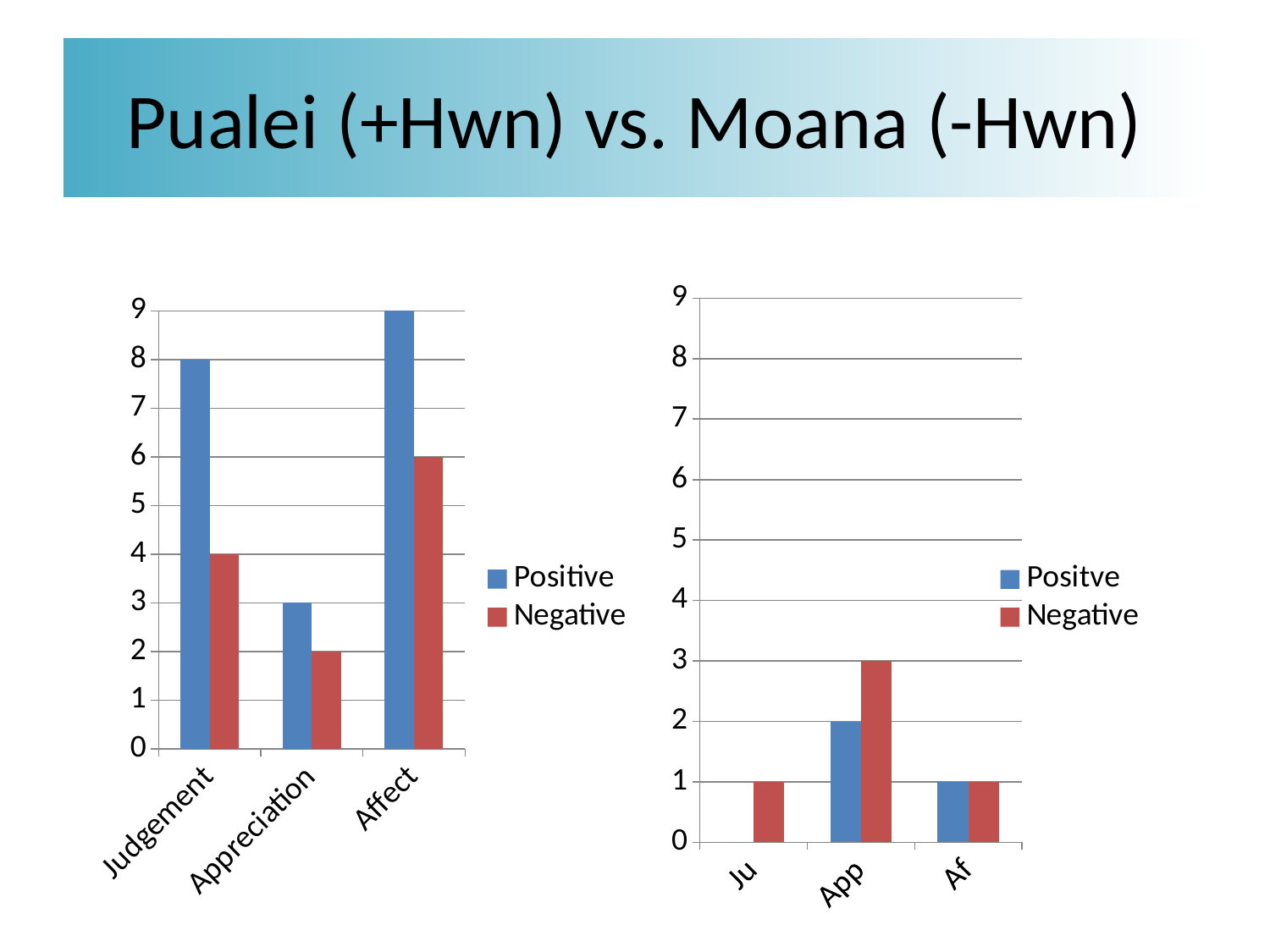
What type of chart is the left chart? bar chart In the left chart, what is the Negative value for Affect? 6 How many categories are shown on the x axis of the right chart? 3 In the left chart, which category has the highest Positive value? Affect How many series does the legend of the left chart list? 2 In the right chart, what is the Negative value for App? 3 In the left chart, what is the Positive value for Judgement? 8 In the left chart, is the Positive value for Appreciation larger or smaller than the Negative value for Judgement? smaller In the right chart, what is the Positive value for Af? 1 In the right chart, which category has the highest Negative value? App In the left chart, what is the difference between the Positive and Negative values for Judgement? 4 In the left chart, which category has the lowest Negative value? Appreciation